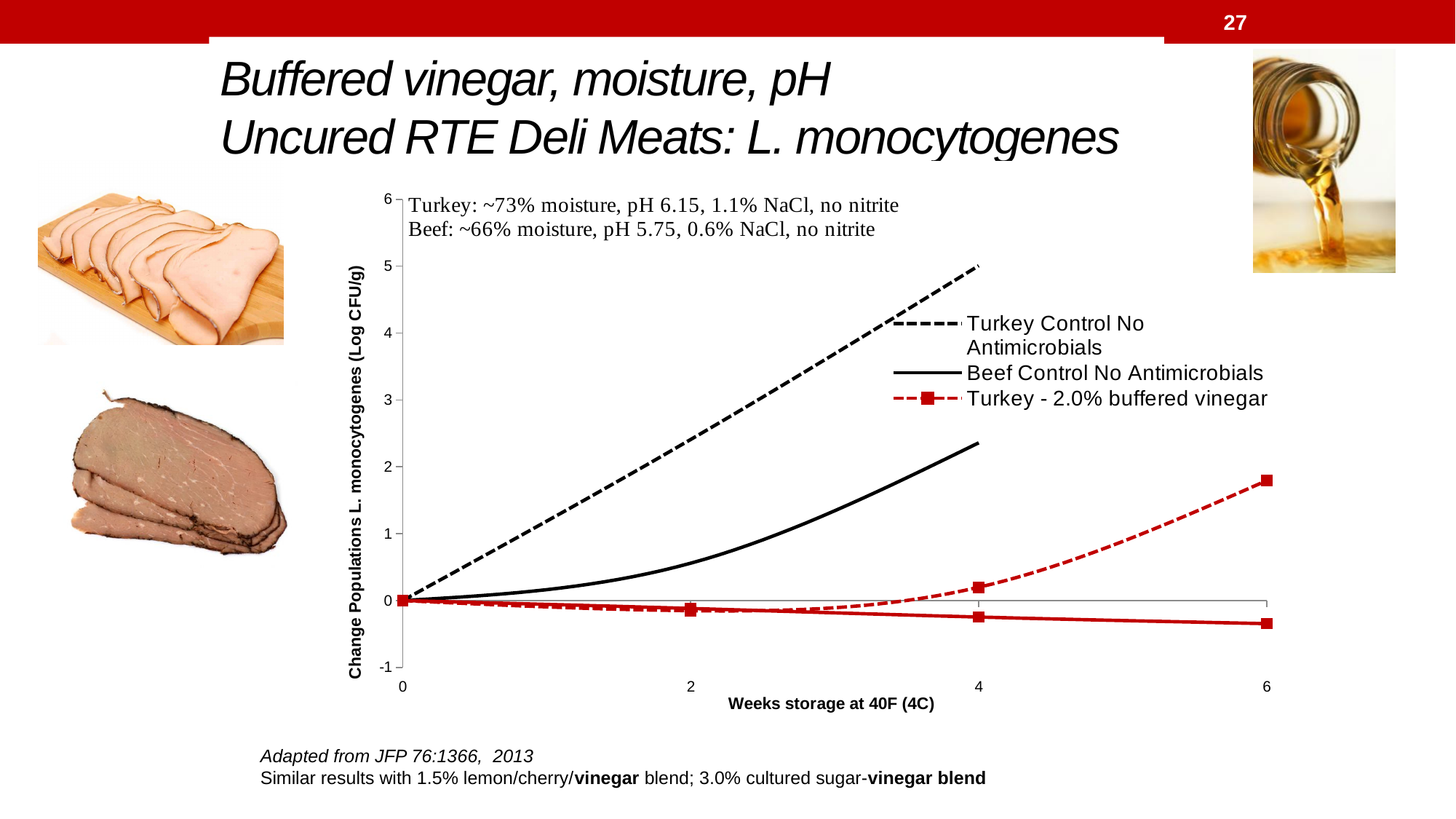
Is the value for Turkey - 2.0% buffered vinegar at week 6 greater or less than 1? greater Which series reaches the highest value on the chart? Turkey Control No Antimicrobials Is the value for Turkey Control No Antimicrobials at week 4 greater or less than 4? greater Does the Turkey Control No Antimicrobials line rise or fall as weeks of storage increase? rise At week 4, which is larger: Turkey Control No Antimicrobials or Beef Control No Antimicrobials? Turkey Control No Antimicrobials What is the title of the x axis? Weeks storage at 40F (4C) What is the value for Turkey - 2.0% buffered vinegar at week 0? 0 What is the title of the y axis? Change Populations L. monocytogenes (Log CFU/g) What kind of chart is shown on the slide? line chart Is the value for Turkey - 2.0% buffered vinegar at week 4 greater or less than 1? less How many series does the chart's legend list? 3